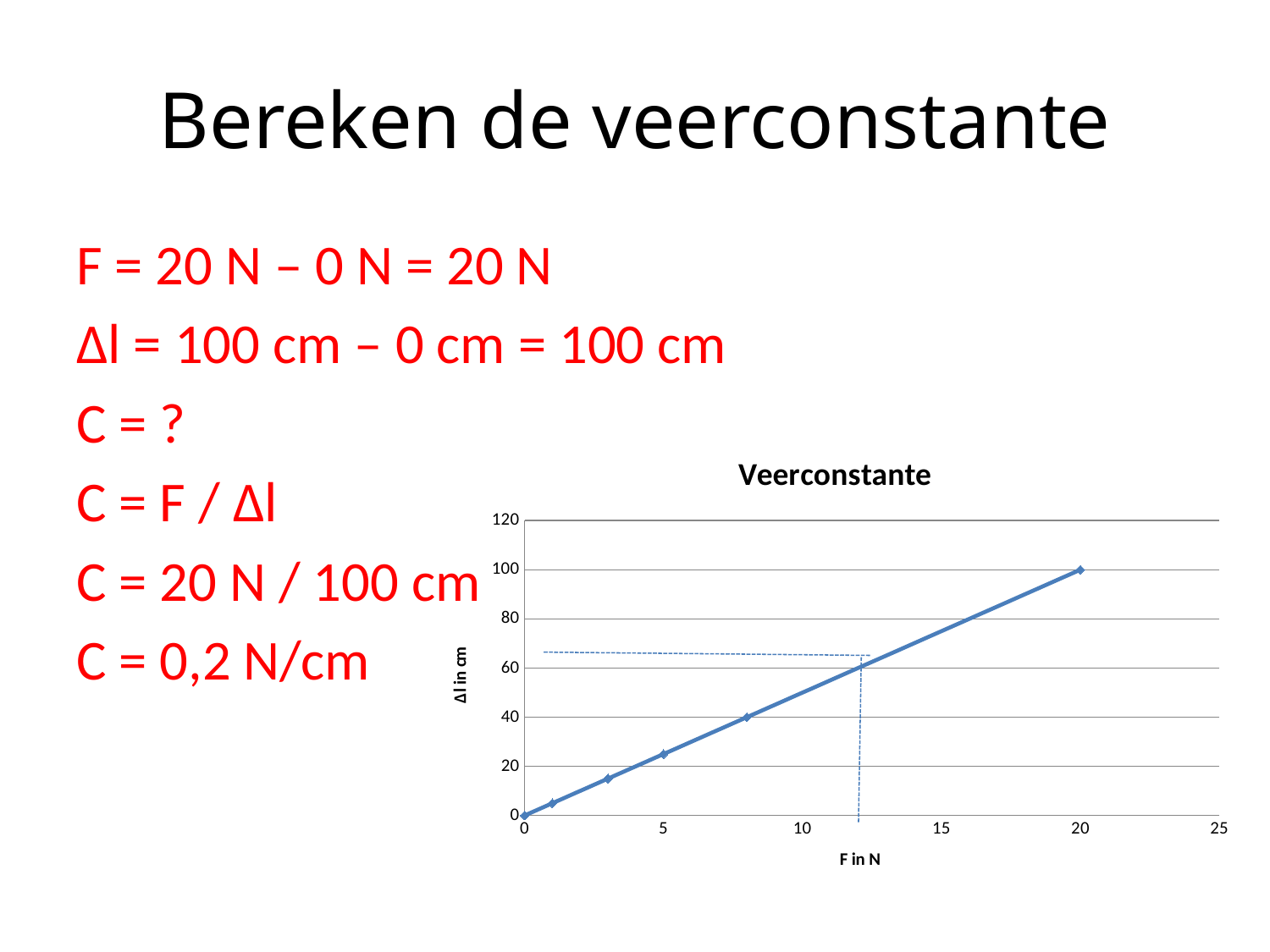
What is the label of the x axis of the chart? F in N Which has the larger Δl value: the point at F = 8 N or the point at F = 5 N? F = 8 N What is the value of Δl at F = 20 N in the chart? 100 Is the value of Δl at F = 8 N greater or less than 20? greater At which value of F is the plotted Δl lowest? 0 Is the value of Δl at F = 20 N greater or less than 80? greater At which value of F is the plotted Δl highest? 20 What is the title of the chart? Veerconstante Is the value of Δl at F = 5 N greater or less than 40? less Do the plotted values rise or fall as F increases along the x axis? rise How many data points are plotted in the chart? 6 What kind of chart is shown on the slide? line chart